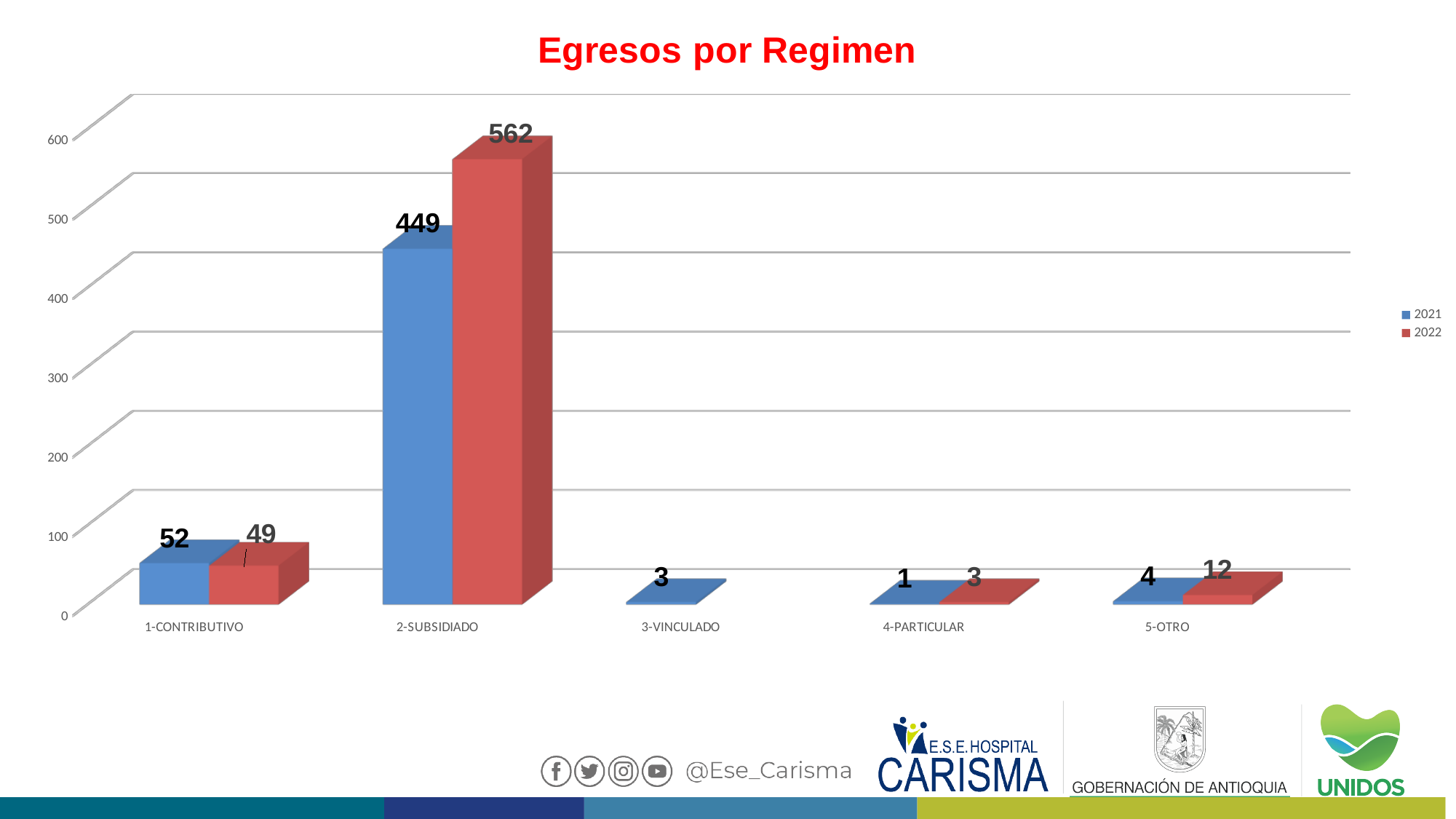
How many series does the legend list? 2 Which category has the lowest 2021 value? 4-PARTICULAR What is the title of the chart? Egresos por Regimen What is the 2021 value for 1-CONTRIBUTIVO? 52 What is the 2022 value for 2-SUBSIDIADO? 562 What type of chart is shown on the slide? bar chart What is the difference between the 2022 and 2021 values for 2-SUBSIDIADO? 113 Which is larger for 1-CONTRIBUTIVO, the 2021 value or the 2022 value? 2021 Which colour represents the 2022 series in the legend? red What is the 2022 value for 5-OTRO? 12 Which category has the highest 2021 value? 2-SUBSIDIADO How many categories are shown on the x axis? 5